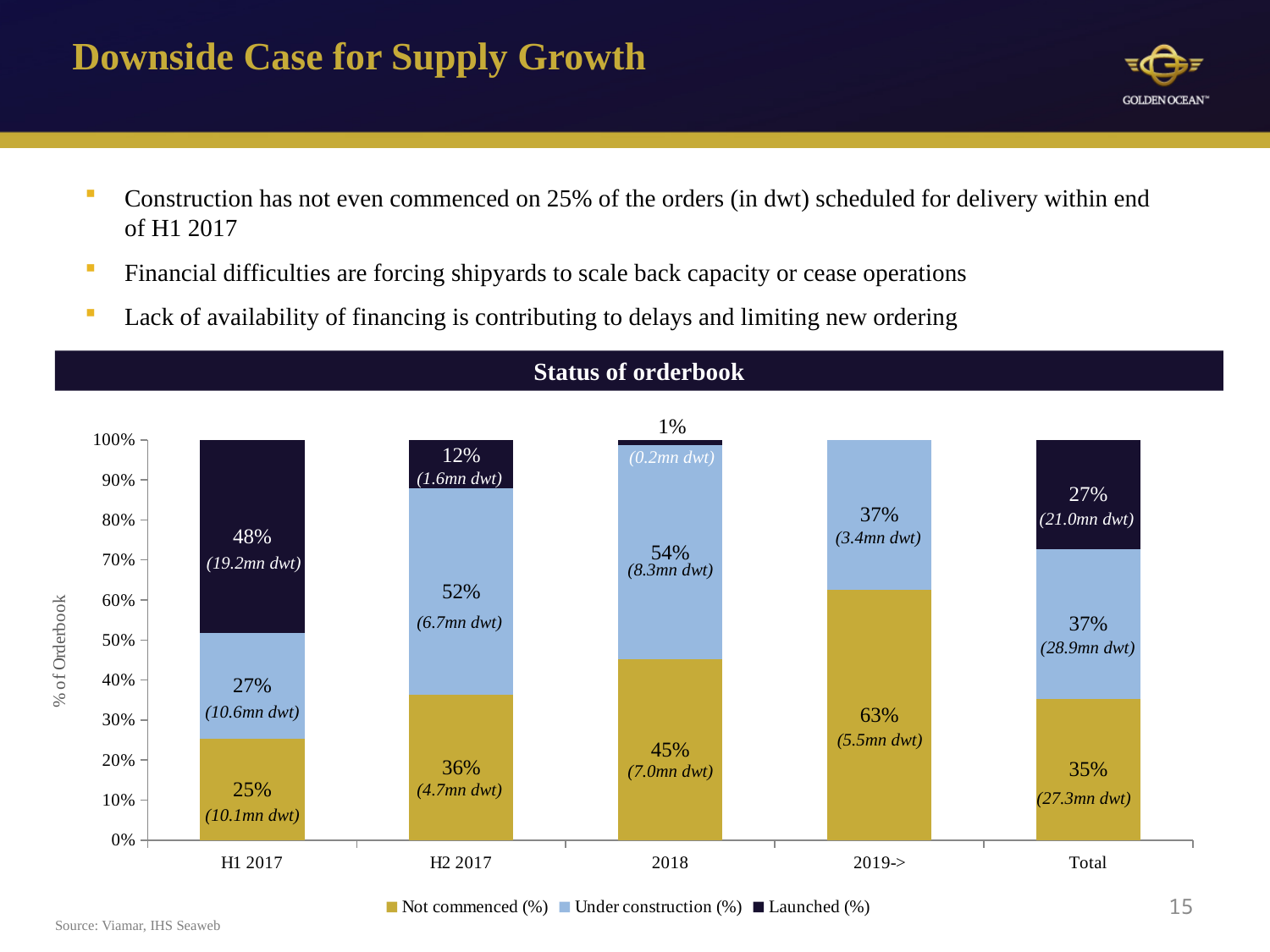
Which is larger: the "Launched" percentage for H1 2017 or for Total? H1 2017 Which category has the highest "Not commenced" percentage? 2019-> What is the "Launched" percentage for 2018? 1% What is the "Not commenced" percentage for H1 2017? 25% How many categories are shown on the x axis of the "Status of orderbook" chart? 5 What type of chart is shown under the title "Status of orderbook"? Stacked bar chart Which category has the lowest "Not commenced" percentage? H1 2017 What is the difference between the "Not commenced" percentage for 2019-> and for H1 2017? 38% What is the "Launched" percentage for H1 2017? 48% What is the "Not commenced" value in mn dwt for the Total category? 27.3mn dwt How many series does the legend of the "Status of orderbook" chart list? 3 What is the "Under construction" percentage for H2 2017? 52%